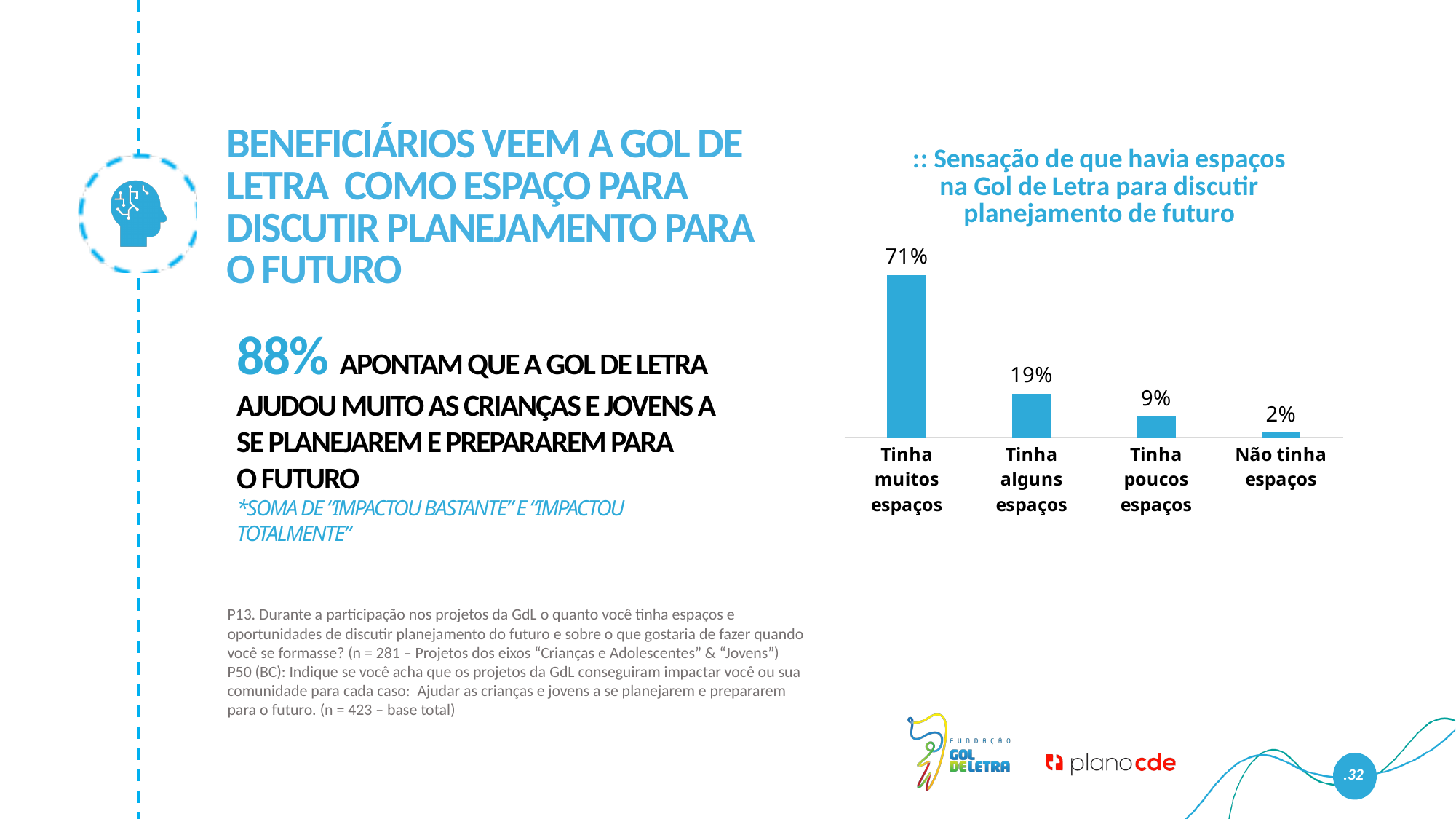
Do the values rise or fall from left to right along the x axis? Fall What is the difference between "Tinha poucos espaços" and "Não tinha espaços"? 7% What kind of chart is shown on the slide? Bar chart What is the value for "Tinha muitos espaços"? 71% Which category has the highest value? Tinha muitos espaços Which is larger, "Tinha alguns espaços" or "Tinha poucos espaços"? Tinha alguns espaços Which category has the lowest value? Não tinha espaços What is the value for "Tinha alguns espaços"? 19% What is the value for "Não tinha espaços"? 2% What is the value for "Tinha poucos espaços"? 9% What is the difference between "Tinha muitos espaços" and "Tinha alguns espaços"? 52% How many categories are shown in the chart? 4